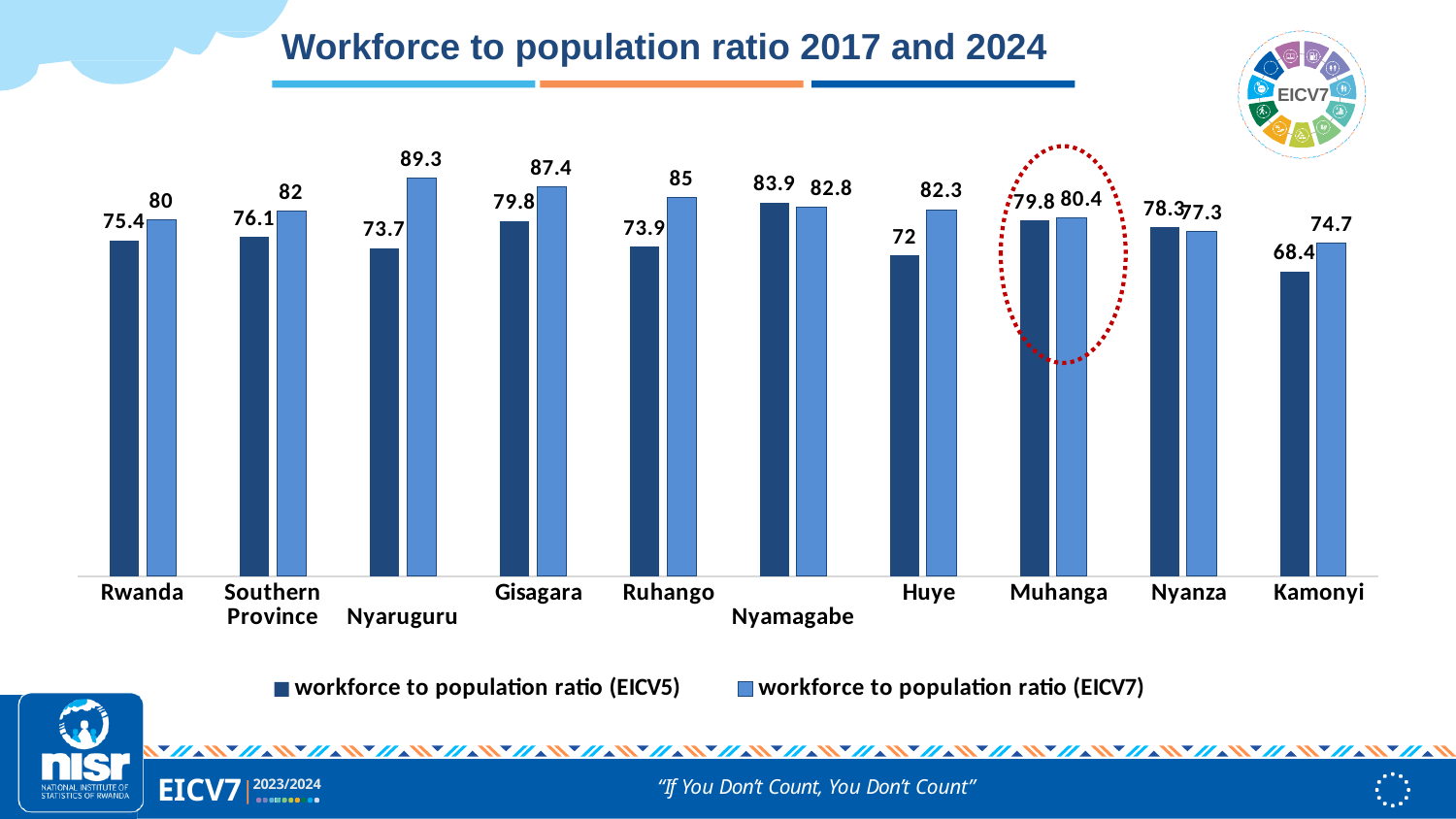
What kind of chart is shown on the slide? Bar chart What is the workforce to population ratio (EICV7) for Kamonyi? 74.7 Which category has the highest workforce to population ratio (EICV7)? Nyaruguru For Nyamagabe, which is larger: the EICV5 or the EICV7 workforce to population ratio? EICV5 What is the difference between the EICV7 and EICV5 workforce to population ratios for Huye? 10.3 How many categories are shown on the x axis? 10 How many series does the legend list? 2 Which category has the highest workforce to population ratio (EICV5)? Nyamagabe Which category has the lowest workforce to population ratio (EICV5)? Kamonyi What is the workforce to population ratio (EICV5) for Huye? 72 What is the workforce to population ratio (EICV7) for Nyaruguru? 89.3 What is the difference between the EICV7 and EICV5 workforce to population ratios for Nyaruguru? 15.6